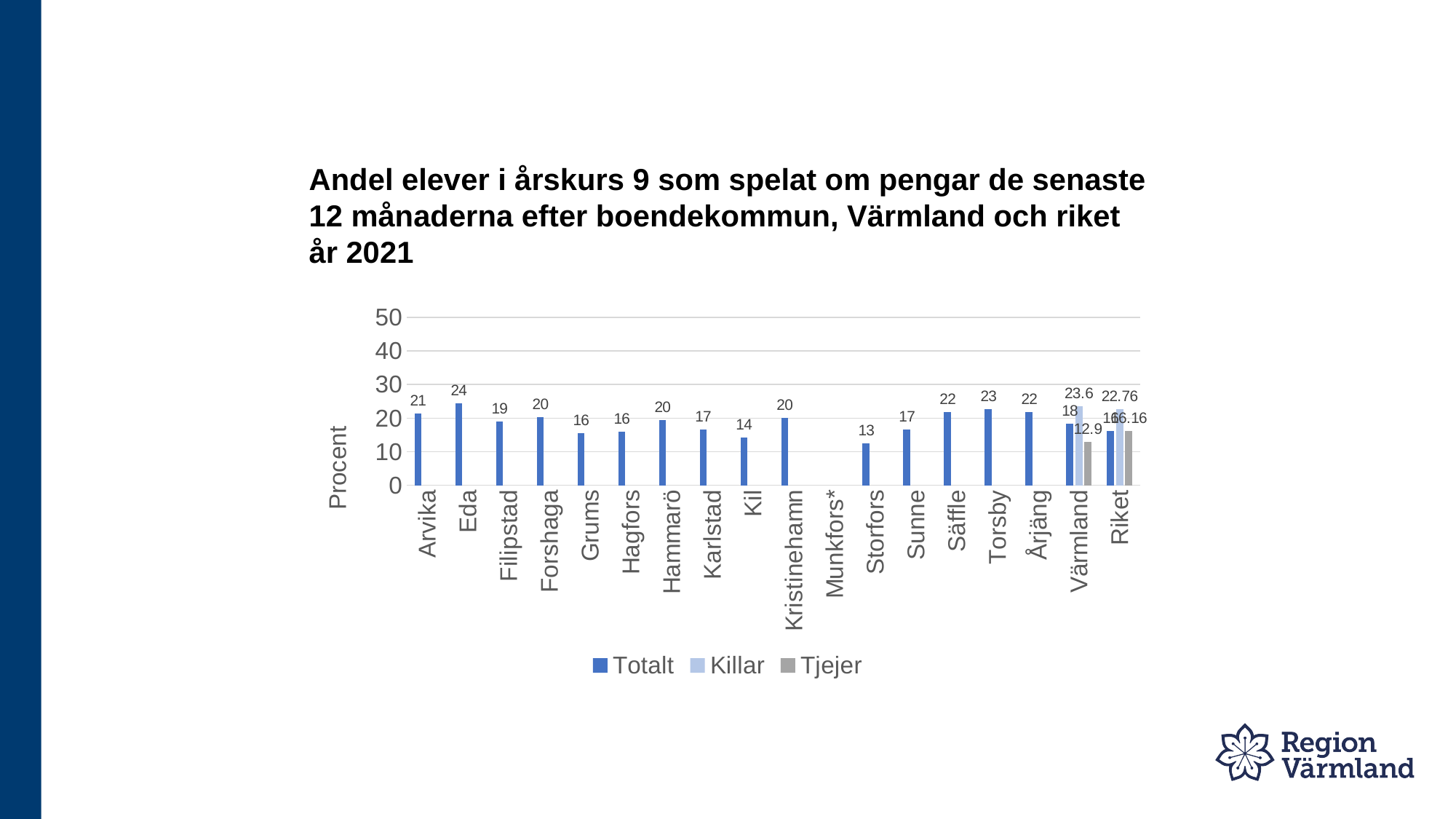
Among the municipalities with a plotted bar, which has the lowest Totalt value? Storfors What is the Killar value for Värmland? 23.6 What is the Totalt value for Eda? 24 Which municipality has the highest Totalt value? Eda What is the Totalt value for Storfors? 13 What kind of chart is shown on the slide? Bar chart How many series does the legend list? 3 Which has a higher Totalt value, Torsby or Säffle? Torsby What is the difference between the Killar and Tjejer values for Värmland? 10.7 What is the difference between the Totalt values for Eda and Storfors? 11 What is the Tjejer value for Värmland? 12.9 What is the label on the vertical axis? Procent